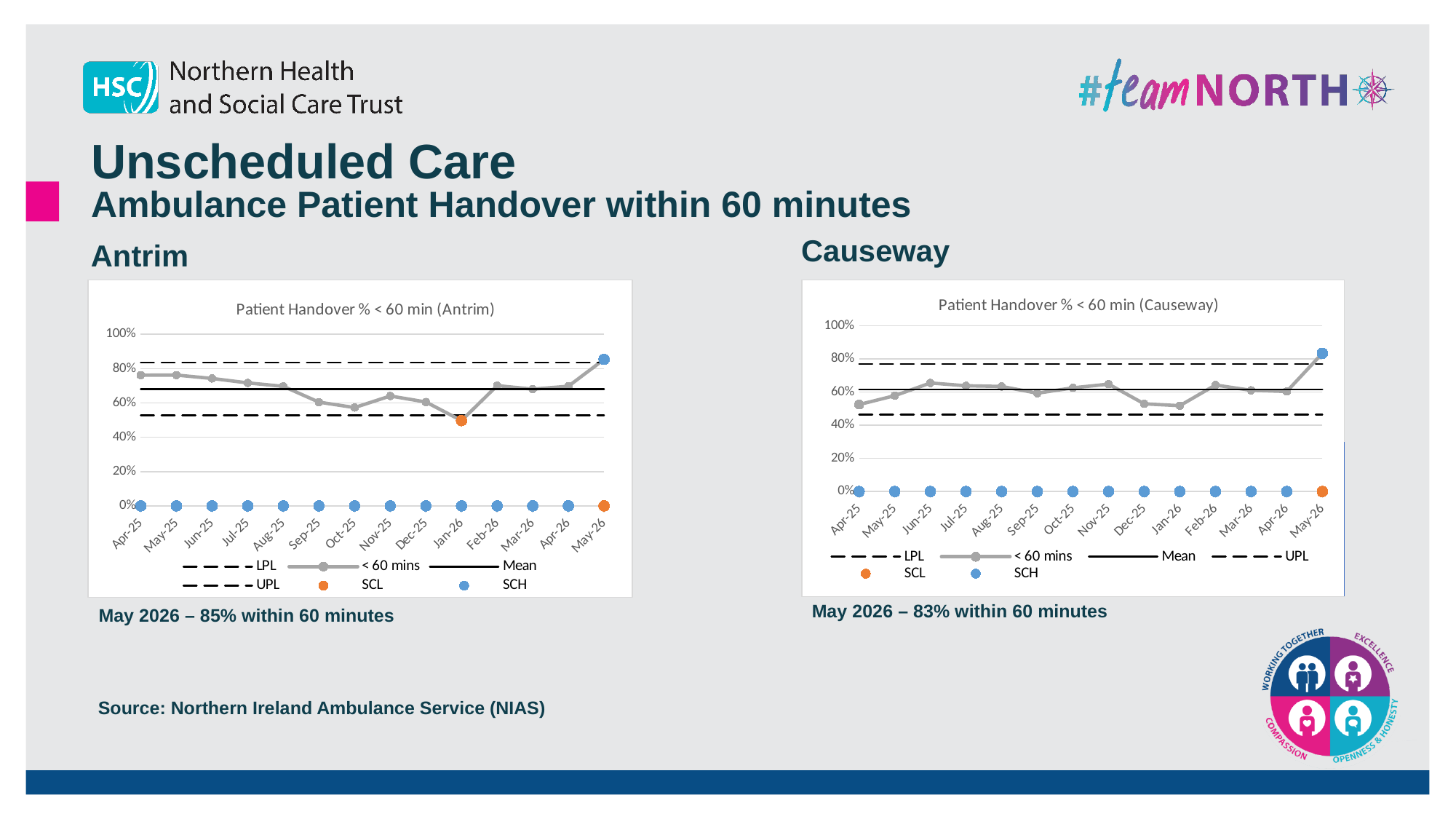
In the Causeway chart, what was the percentage of patient handovers within 60 minutes in May-26? 83% In the Antrim chart, which month has the highest < 60 mins value? May-26 In the Antrim chart, which month has the lowest < 60 mins value? Jan-26 In the Antrim chart, which month has the larger < 60 mins value, Apr-25 or Oct-25? Apr-25 In the Antrim chart, is the < 60 mins value for Jan-26 greater or less than 60%? less What kind of chart is the Antrim chart? Line chart In the Causeway chart, which month has the highest < 60 mins value? May-26 In the Antrim chart, what was the percentage of patient handovers within 60 minutes in May-26? 85% Comparing the May-26 values, which site had the higher percentage of handovers within 60 minutes, Antrim or Causeway? Antrim In the Causeway chart, is the < 60 mins value for Jan-26 greater or less than 60%? less What is the difference between the Antrim and Causeway May-26 handover percentages? 2 percentage points How many months are plotted on the x axis of the Causeway chart? 14